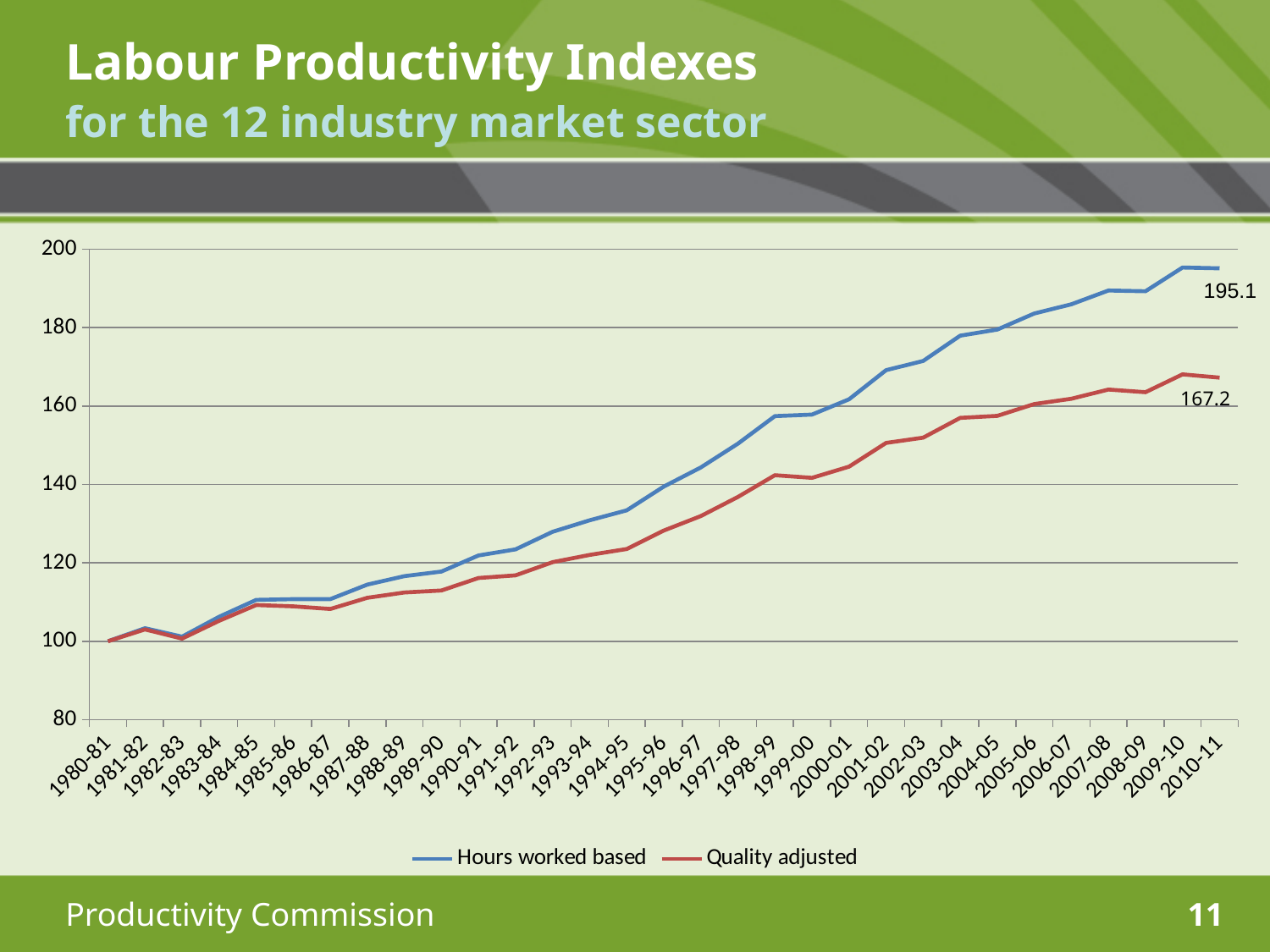
What is the value of the Quality adjusted series in 2010-11? 167.2 Is the value for Quality adjusted in 1990-91 greater or less than 120? less Is the value for Hours worked based in 1998-99 greater or less than 140? greater Do the values of the Hours worked based series generally rise or fall from 1980-81 to 2010-11? Rise What is the value of the Hours worked based series in 2010-11? 195.1 Which colour is used for the Quality adjusted series? Red How many series does the legend list? 2 How many years are shown along the x axis? 31 What kind of chart is shown on the slide? Line chart Which series has the higher value in 2010-11, Hours worked based or Quality adjusted? Hours worked based What is the value of both series in 1980-81? 100 What is the difference between the Hours worked based and Quality adjusted values in 2010-11? 27.9